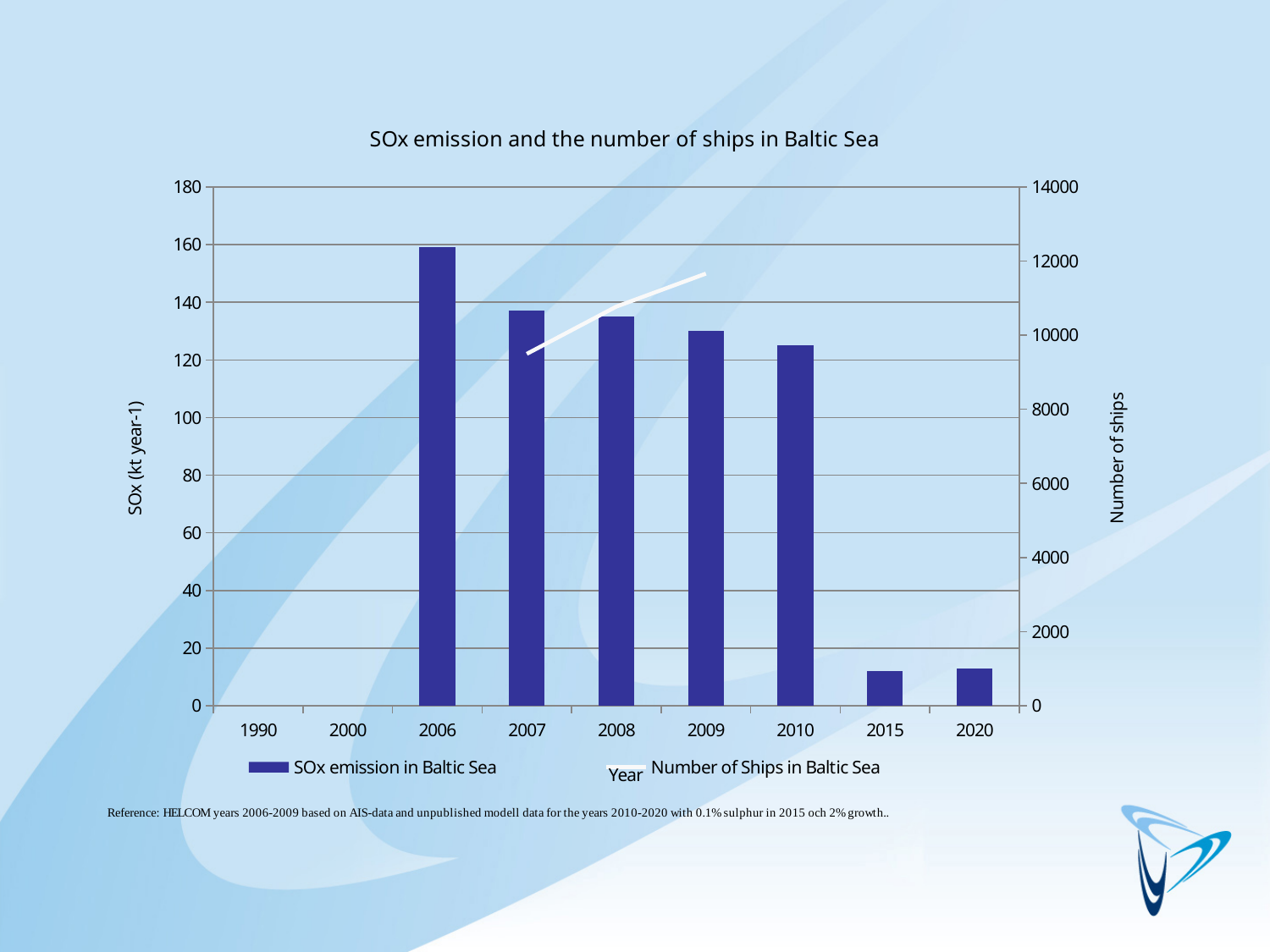
What is the title of the chart? SOx emission and the number of ships in Baltic Sea How many series does the legend list? 2 How many year labels are shown on the x axis? 9 Is the SOx emission in Baltic Sea for 2015 greater or less than 20? less Is the SOx emission in Baltic Sea for 2006 greater or less than 140? greater How many bars are plotted for SOx emission in Baltic Sea? 7 Is the SOx emission in Baltic Sea for 2007 greater or less than 140? less What is the label of the right-hand vertical axis? Number of ships What kind of chart is used to show SOx emission in Baltic Sea? bar chart Do the SOx emission bars rise or fall from 2006 to 2010? fall Which year has the larger SOx emission in Baltic Sea, 2010 or 2015? 2010 Which year has the highest SOx emission in Baltic Sea? 2006